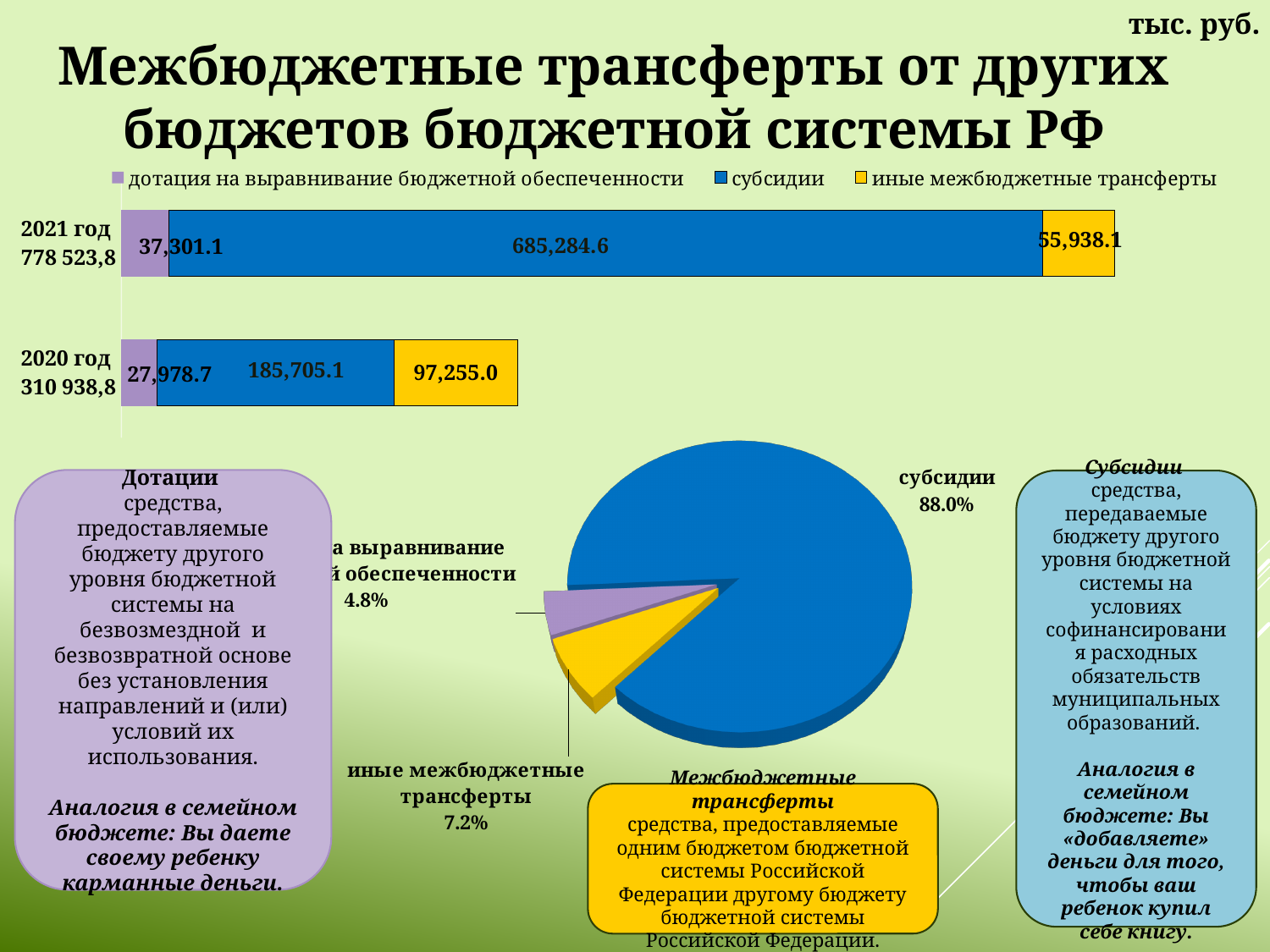
What kind of chart is the upper chart on the slide? Stacked bar chart In the pie chart, what share does иные межбюджетные трансферты have? 7.2% How many series does the legend of the stacked bar chart list? 3 In the pie chart, which slice is the smallest? дотация на выравнивание бюджетной обеспеченности In the stacked bar chart, what is the total shown for 2021 год? 778 523,8 In the stacked bar chart, what is the value of дотация на выравнивание бюджетной обеспеченности for 2021 год? 37,301.1 In the stacked bar chart, what is the value of иные межбюджетные трансферты for 2020 год? 97,255.0 In the stacked bar chart, what is the value of субсидии for 2020 год? 185,705.1 In the pie chart, what share does субсидии have? 88.0% In the stacked bar chart, which year has the larger value for иные межбюджетные трансферты, 2021 год or 2020 год? 2020 год In the stacked bar chart, what is the difference between the субсидии values for 2021 год and 2020 год? 499,579.5 In the stacked bar chart, what is the value of субсидии for 2021 год? 685,284.6